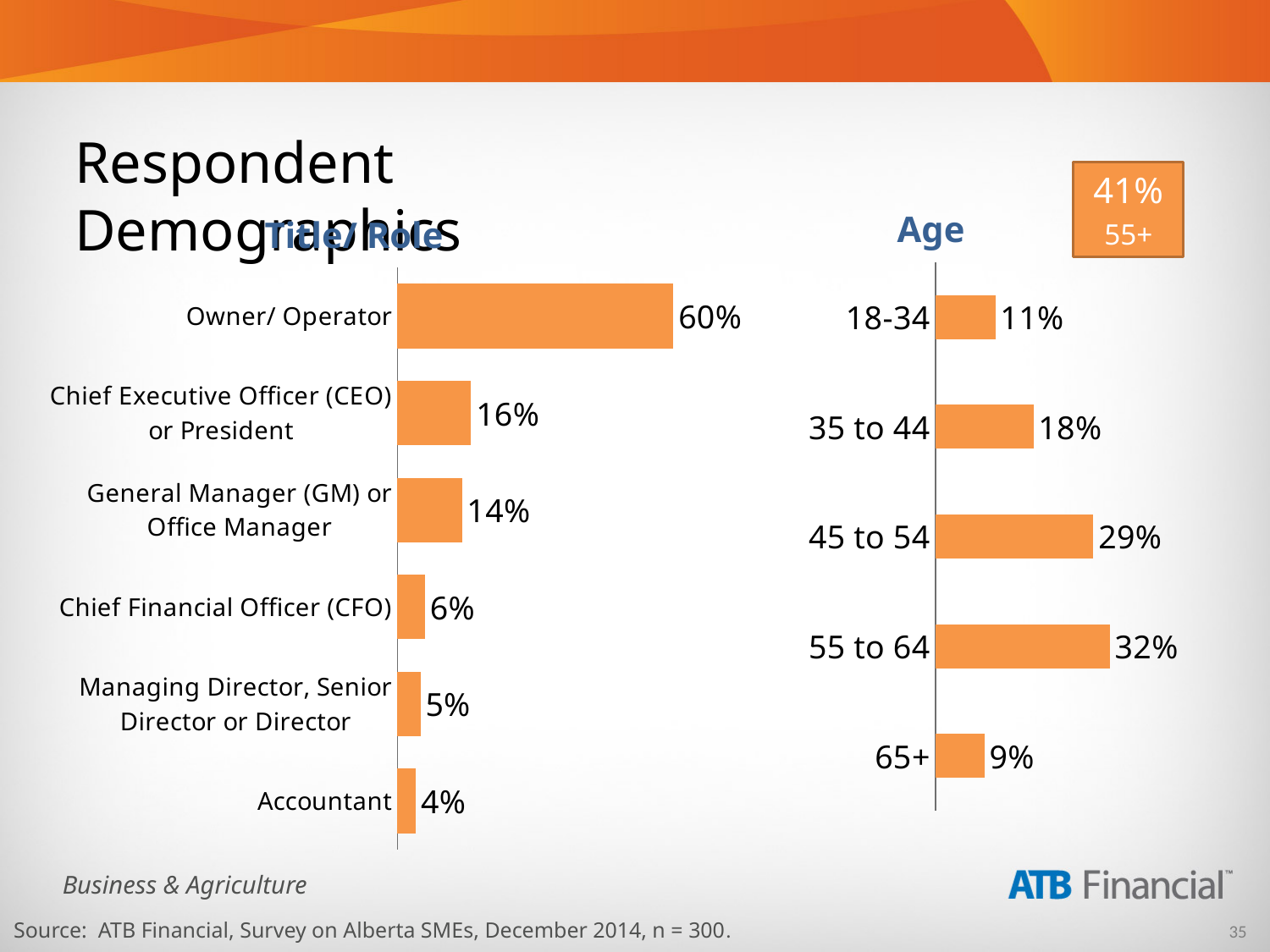
In the Title/Role chart on the left, what percentage of respondents are Chief Financial Officer (CFO)? 6% In the Age chart on the right, what percentage of respondents are aged 65+? 9% How many age groups are shown in the Age chart on the right? 5 In the Age chart on the right, which is larger: the percentage for 18-34 or for 35 to 44? 35 to 44 In the Age chart on the right, what percentage of respondents are aged 45 to 54? 29% In the Title/Role chart on the left, which role has the lowest percentage? Accountant How many roles are shown in the Title/Role chart on the left? 6 In the Title/Role chart on the left, what percentage of respondents are Owner/ Operator? 60% In the Age chart on the right, which age group has the highest percentage? 55 to 64 What type of chart is the Age chart on the right? Bar chart In the Age chart on the right, which age group has the lowest percentage? 65+ In the Title/Role chart on the left, what is the difference in percentage points between Owner/ Operator and Chief Executive Officer (CEO) or President? 44